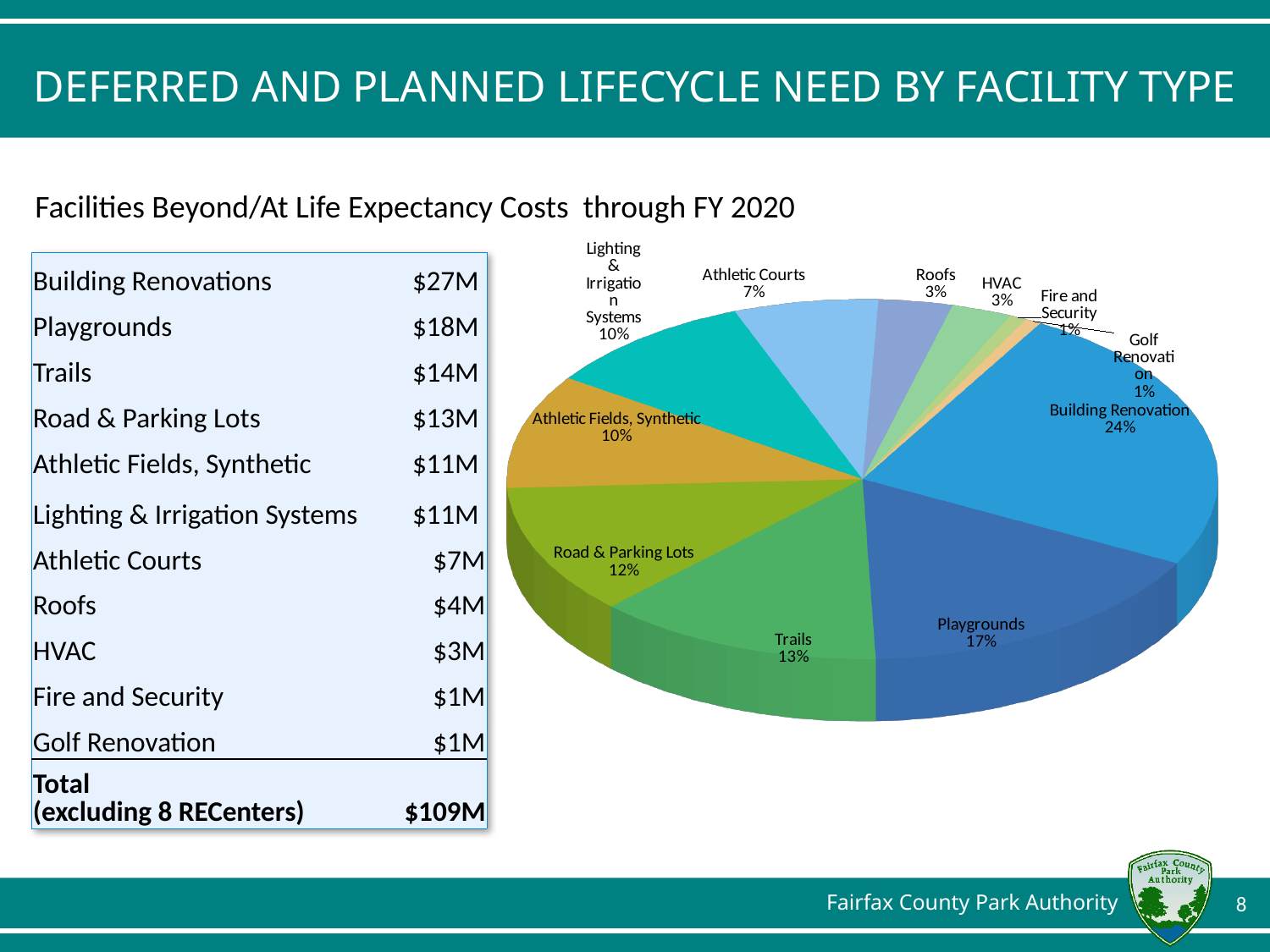
What percentage is shown for Trails in the pie chart? 13% Which slice is larger in the pie chart, Trails or Athletic Courts? Trails What percentage is shown for Roofs in the pie chart? 3% What percentage is shown for Golf Renovation in the pie chart? 1% What share of the pie chart does Building Renovation represent? 24% How many slices does the pie chart have? 11 Which category has the largest slice in the pie chart? Building Renovation What percentage is shown for Athletic Courts in the pie chart? 7% What percentage is shown for Road & Parking Lots in the pie chart? 12% What type of chart is shown on the slide? Pie chart What is the difference in percentage points between Building Renovation and Playgrounds in the pie chart? 7 What percentage is shown for Playgrounds in the pie chart? 17%